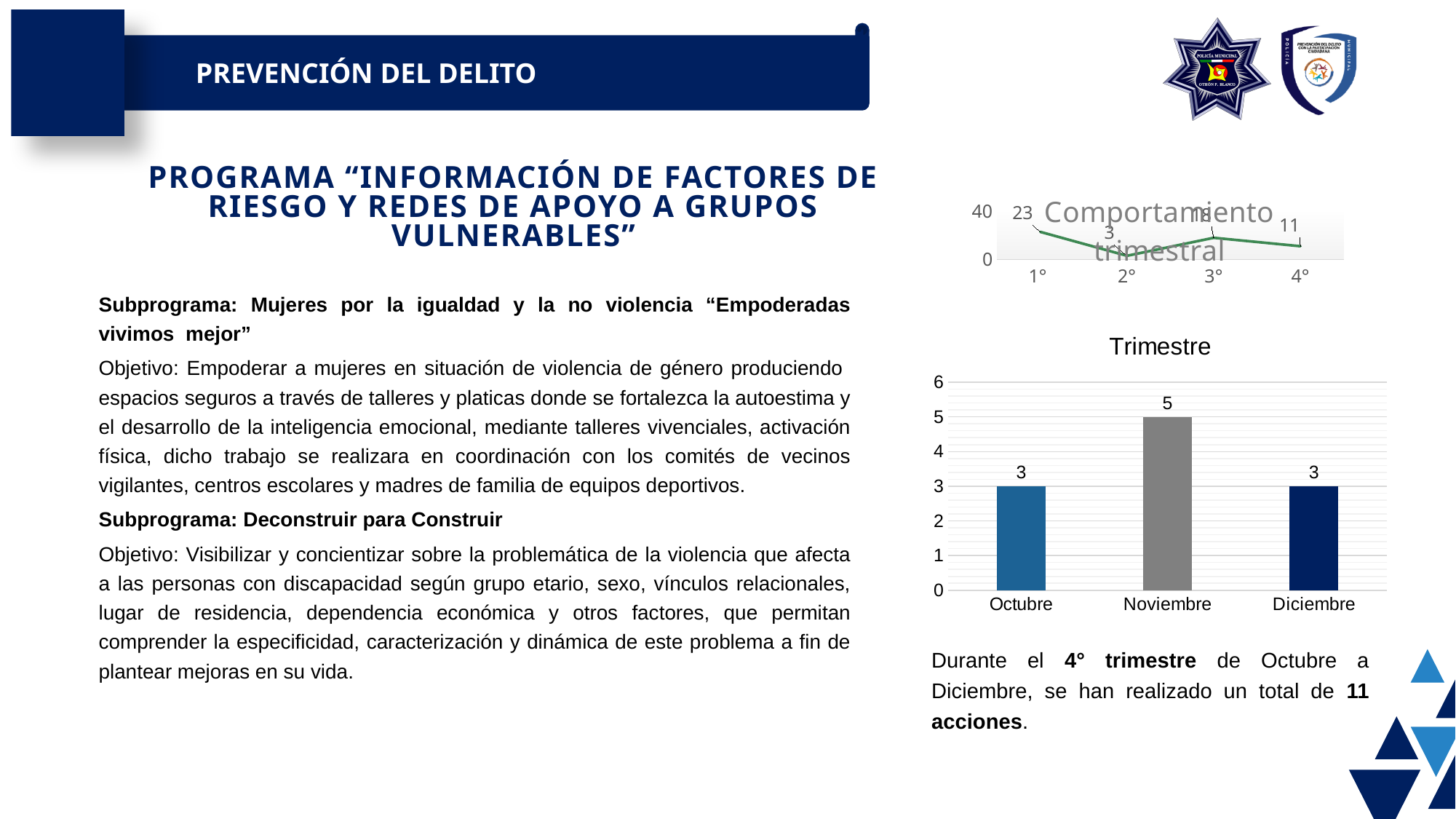
In the "Trimestre" chart, what is the value for Octubre? 3 What kind of chart is the "Comportamiento trimestral" chart? line chart In the "Comportamiento trimestral" chart, is the value for 1° larger or smaller than the value for 2°? larger In the "Comportamiento trimestral" chart, what is the value for 1°? 23 In the "Comportamiento trimestral" chart, what is the value for 4°? 11 What kind of chart is the "Trimestre" chart? bar chart In the "Trimestre" chart, which month has the highest value? Noviembre In the "Trimestre" chart, is the value for Noviembre larger or smaller than the value for Diciembre? larger In the "Trimestre" chart, what is the difference between the values for Noviembre and Octubre? 2 How many months are shown in the "Trimestre" chart? 3 In the "Trimestre" chart, what is the value for Noviembre? 5 In the "Trimestre" chart, what is the value for Diciembre? 3